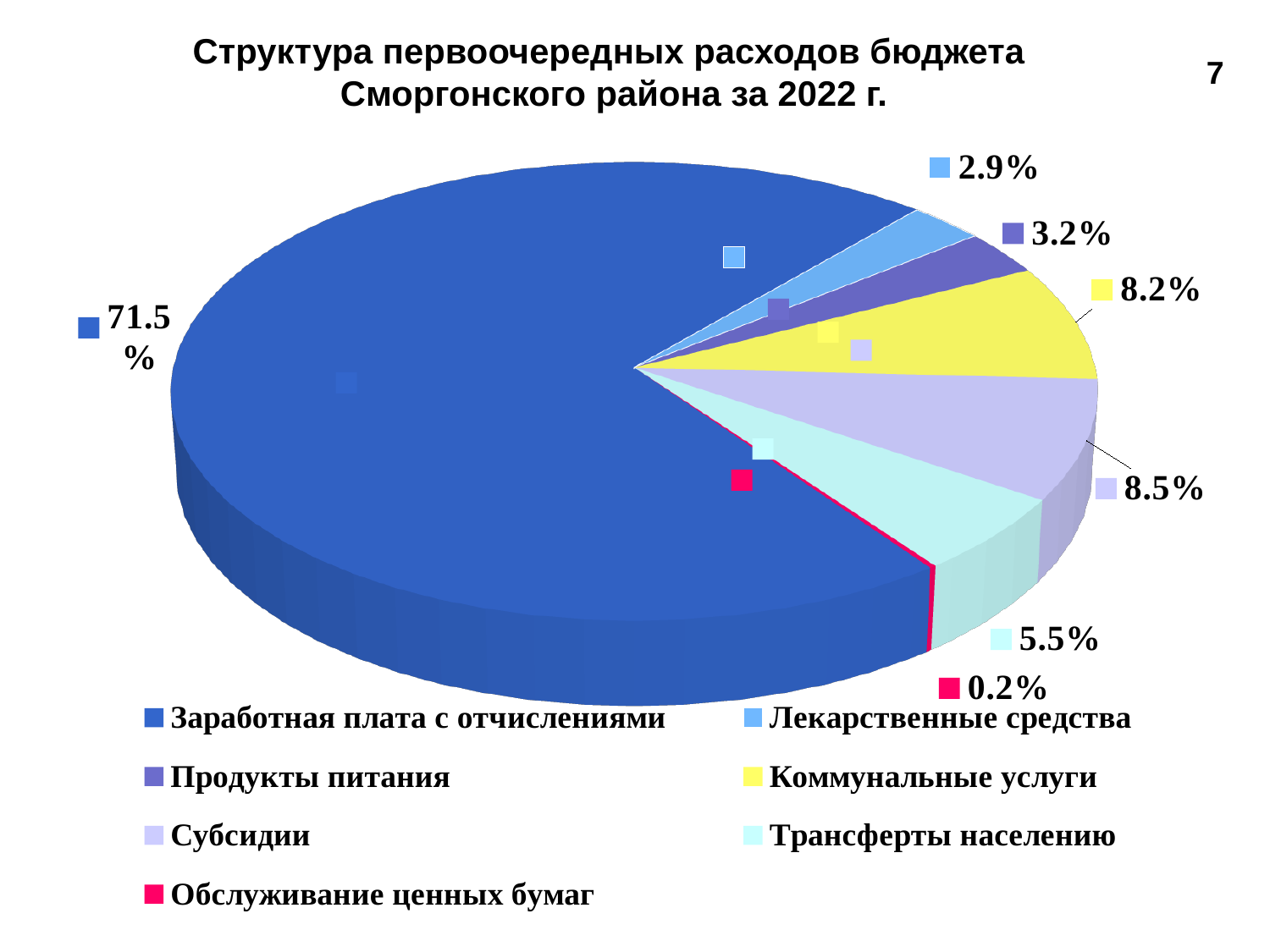
Which category has the largest share of the pie? Заработная плата с отчислениями Which is larger, the share for Трансферты населению or the share for Продукты питания? Трансферты населению How many categories does the legend list? 7 Which category has the smallest share of the pie? Обслуживание ценных бумаг What is the difference between the shares of Субсидии and Коммунальные услуги? 0.3% What share of the pie does Заработная плата с отчислениями take? 71.5% What is the value shown for Коммунальные услуги? 8.2% What is the title of the chart? Структура первоочередных расходов бюджета Сморгонского района за 2022 г. What is the value shown for Обслуживание ценных бумаг? 0.2% What is the value shown for Субсидии? 8.5% What kind of chart is shown on the slide? Pie chart What is the value shown for Лекарственные средства? 2.9%